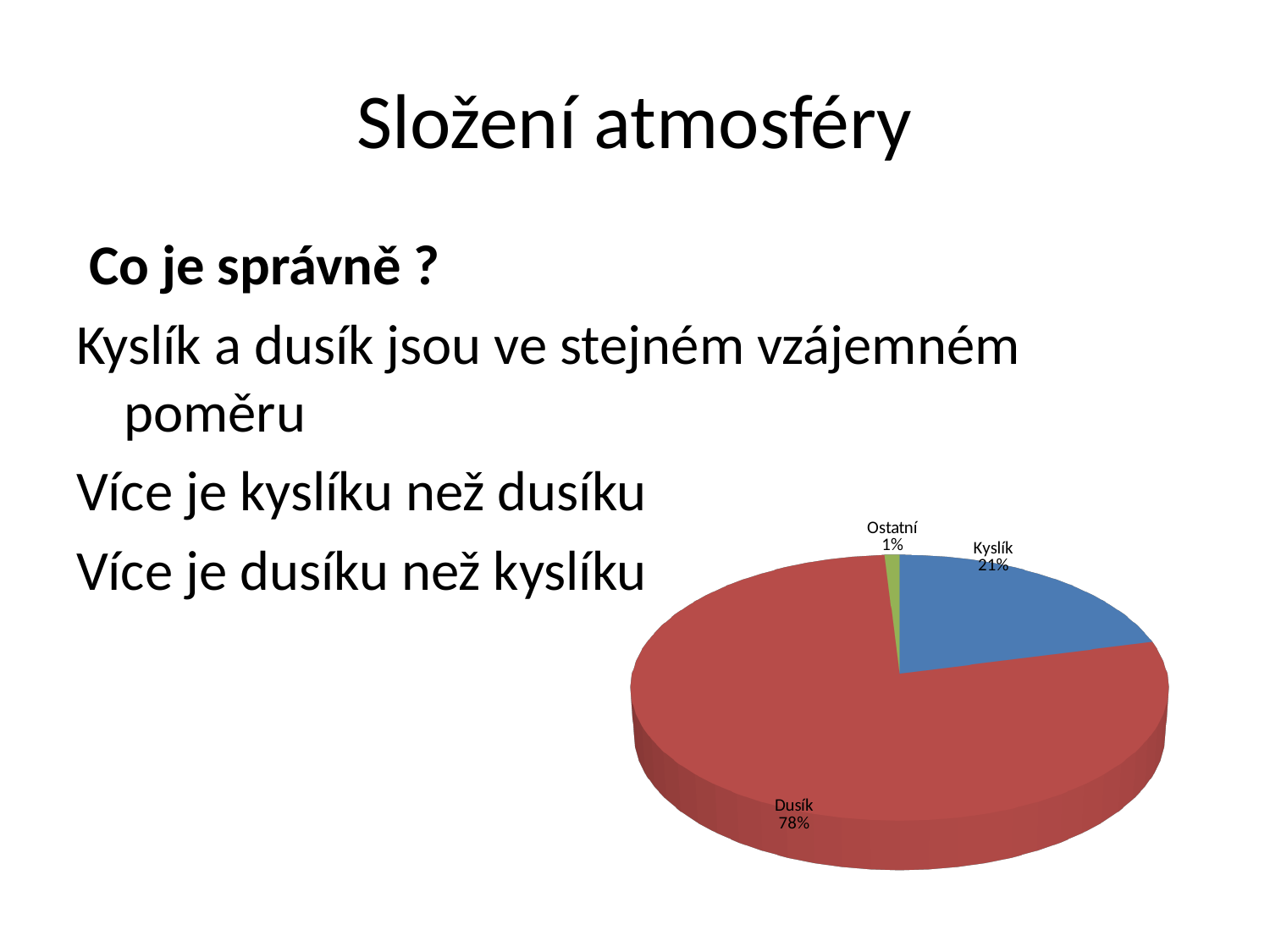
What is the difference in percentage points between Dusík and Kyslík? 57 What share of the pie does Ostatní have? 1% What colour is the Kyslík slice of the pie? blue How many slices does the pie chart have? 3 What share of the pie does Kyslík have? 21% What kind of chart is shown on the slide? pie chart Which is larger, the share for Kyslík or the share for Ostatní? Kyslík What is the difference in percentage points between Kyslík and Ostatní? 20 What share of the pie does Dusík have? 78% Which slice of the pie is the smallest? Ostatní Which slice of the pie is the largest? Dusík What colour is the Dusík slice of the pie? red